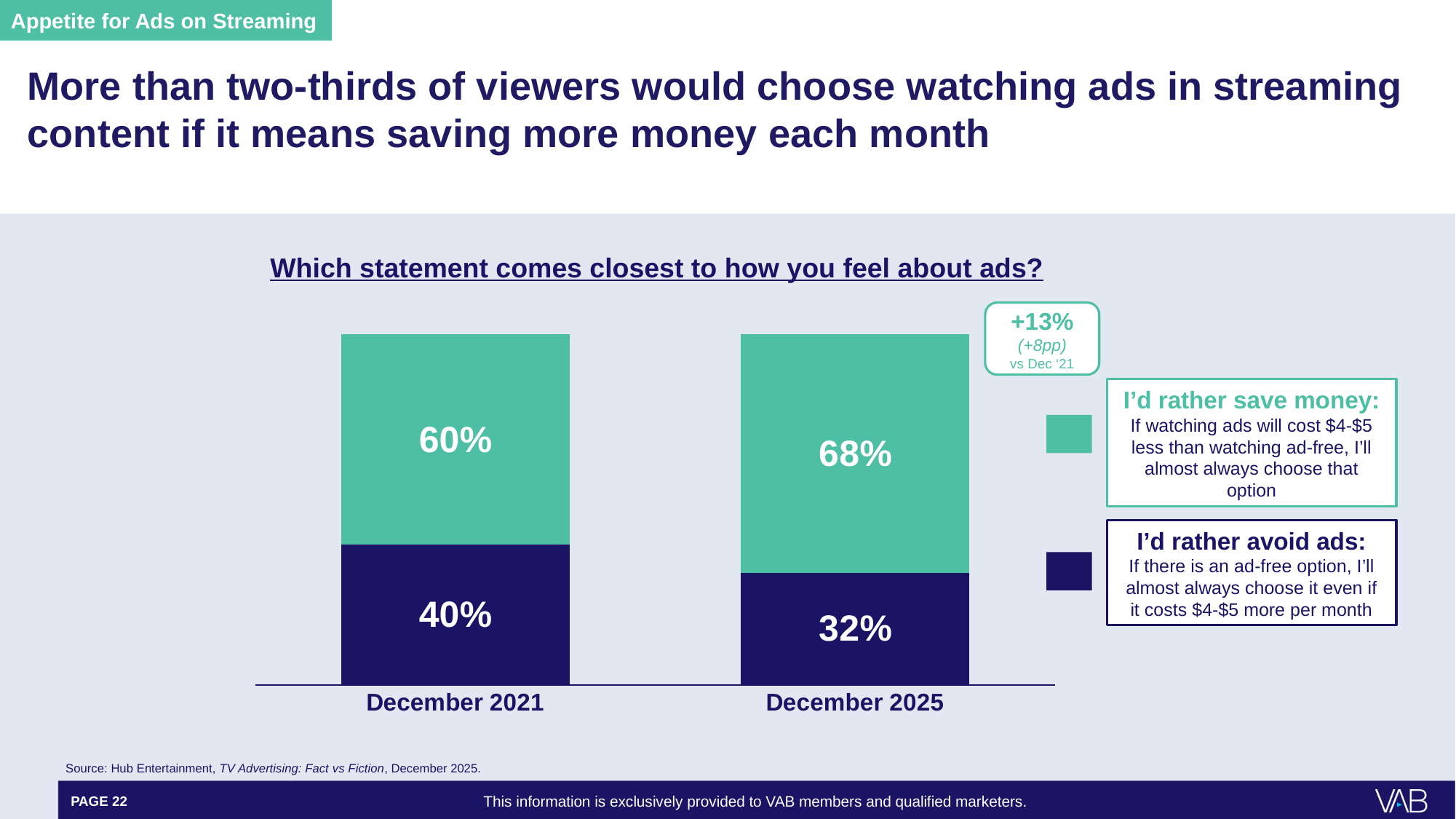
What is the total of the stacked bar for December 2021? 100% What percentage of viewers said "I'd rather save money" in December 2025? 68% What percentage of viewers said "I'd rather avoid ads" in December 2021? 40% How many series does the legend list? 2 What percentage of viewers said "I'd rather save money" in December 2021? 60% How many time periods (bars) are shown on the chart? 2 What kind of chart is shown on the slide? Stacked bar chart What is the title of the chart? Which statement comes closest to how you feel about ads? What percentage of viewers said "I'd rather avoid ads" in December 2025? 32% In December 2025, which is larger: the share who would rather save money or the share who would rather avoid ads? I'd rather save money By how many percentage points did the "I'd rather save money" share change from December 2021 to December 2025? 8 percentage points Did the "I'd rather avoid ads" share rise or fall from December 2021 to December 2025? Fall